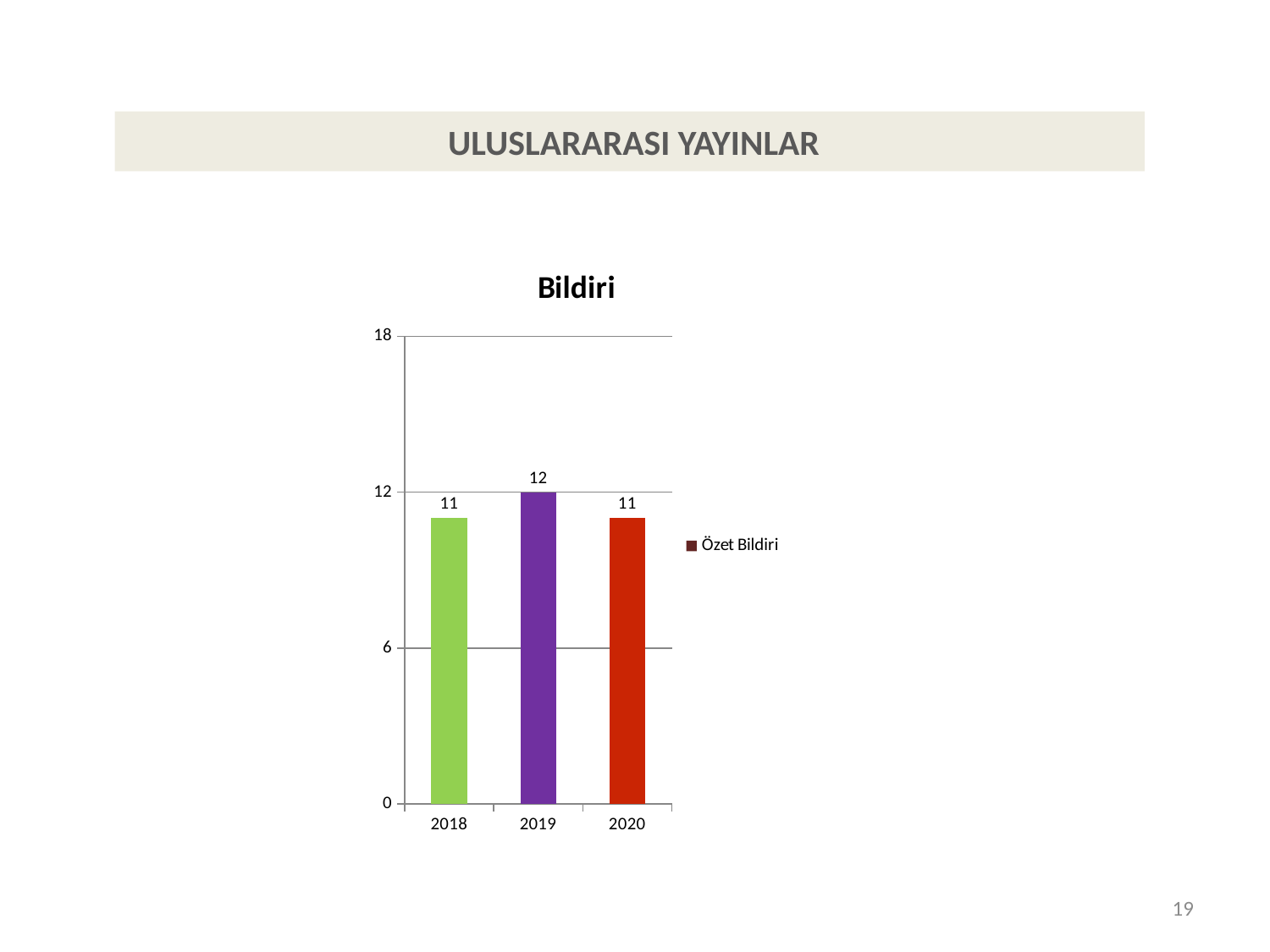
Which is larger, the value for 2019 or the value for 2020? 2019 Is the value for 2019 greater or less than 6? greater What is the difference between the values for 2019 and 2018? 1 How many years are shown on the x axis of the chart? 3 What is the title of the chart? Bildiri What kind of chart is shown on the slide? bar chart Is the value for 2018 greater or less than 12? less What is the value for 2020 in the Bildiri chart? 11 What is the value for 2019 in the Bildiri chart? 12 How many series does the legend list? 1 Which year has the highest value in the Bildiri chart? 2019 What is the value for 2018 in the Bildiri chart? 11